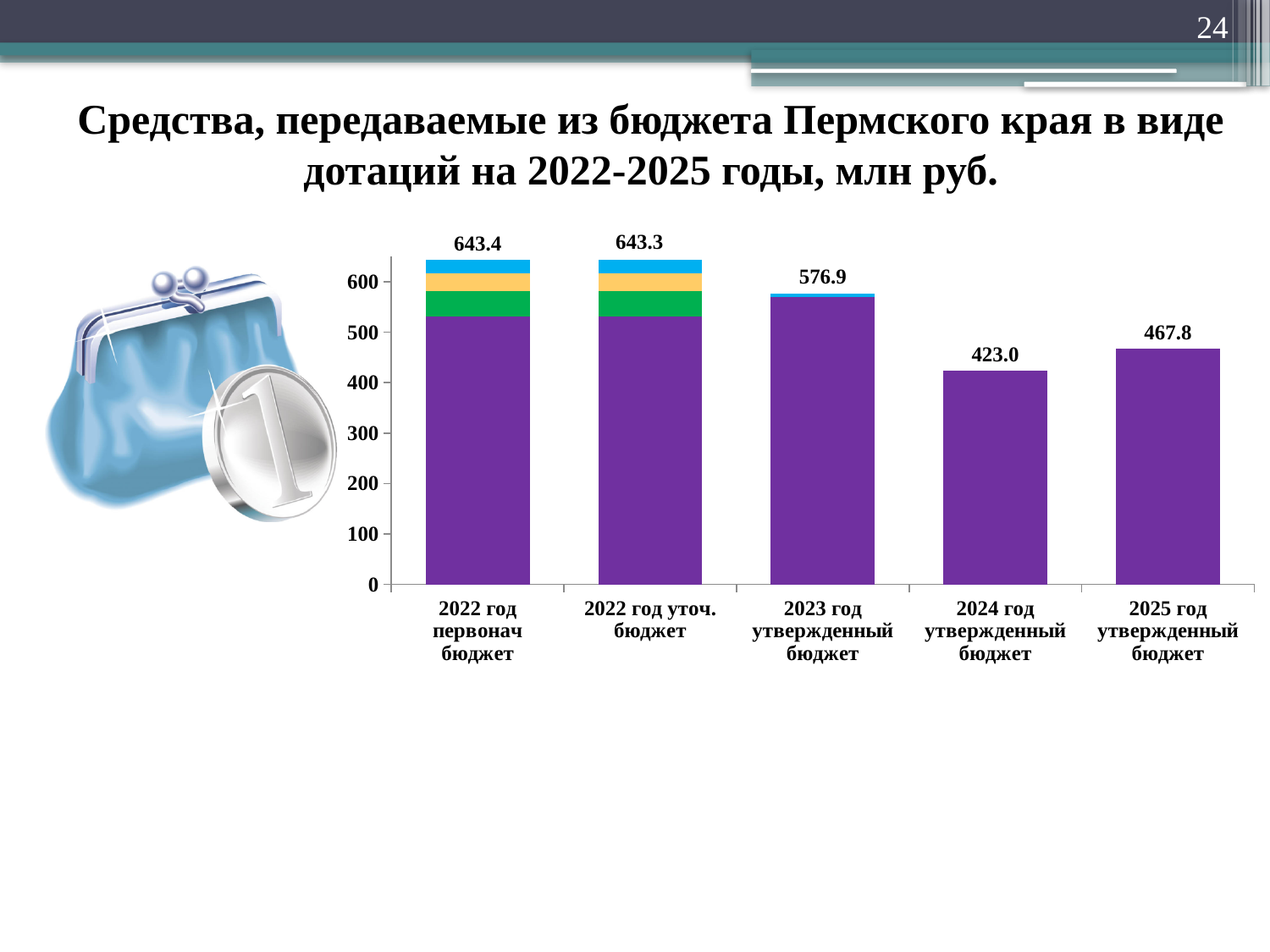
Do the totals rise or fall from 2023 год утвержденный бюджет to 2024 год утвержденный бюджет? fall What is the difference between the totals for 2023 год утвержденный бюджет and 2024 год утвержденный бюджет? 153.9 Which category has the lowest total value? 2024 год утвержденный бюджет What is the total value shown for the 2024 год утвержденный бюджет bar? 423.0 What is the total value shown for the 2023 год утвержденный бюджет bar? 576.9 What kind of chart is shown on the slide? bar chart Which is larger: the total for 2025 год утвержденный бюджет or for 2024 год утвержденный бюджет? 2025 год утвержденный бюджет What is the total value shown for the 2022 год первонач бюджет bar? 643.4 What is the total value shown for the 2025 год утвержденный бюджет bar? 467.8 Is the purple (bottom) segment of the 2022 год первонач бюджет bar greater or less than 500? greater How many categories are shown on the x axis? 5 What is the difference between the totals for 2025 год утвержденный бюджет and 2024 год утвержденный бюджет? 44.8